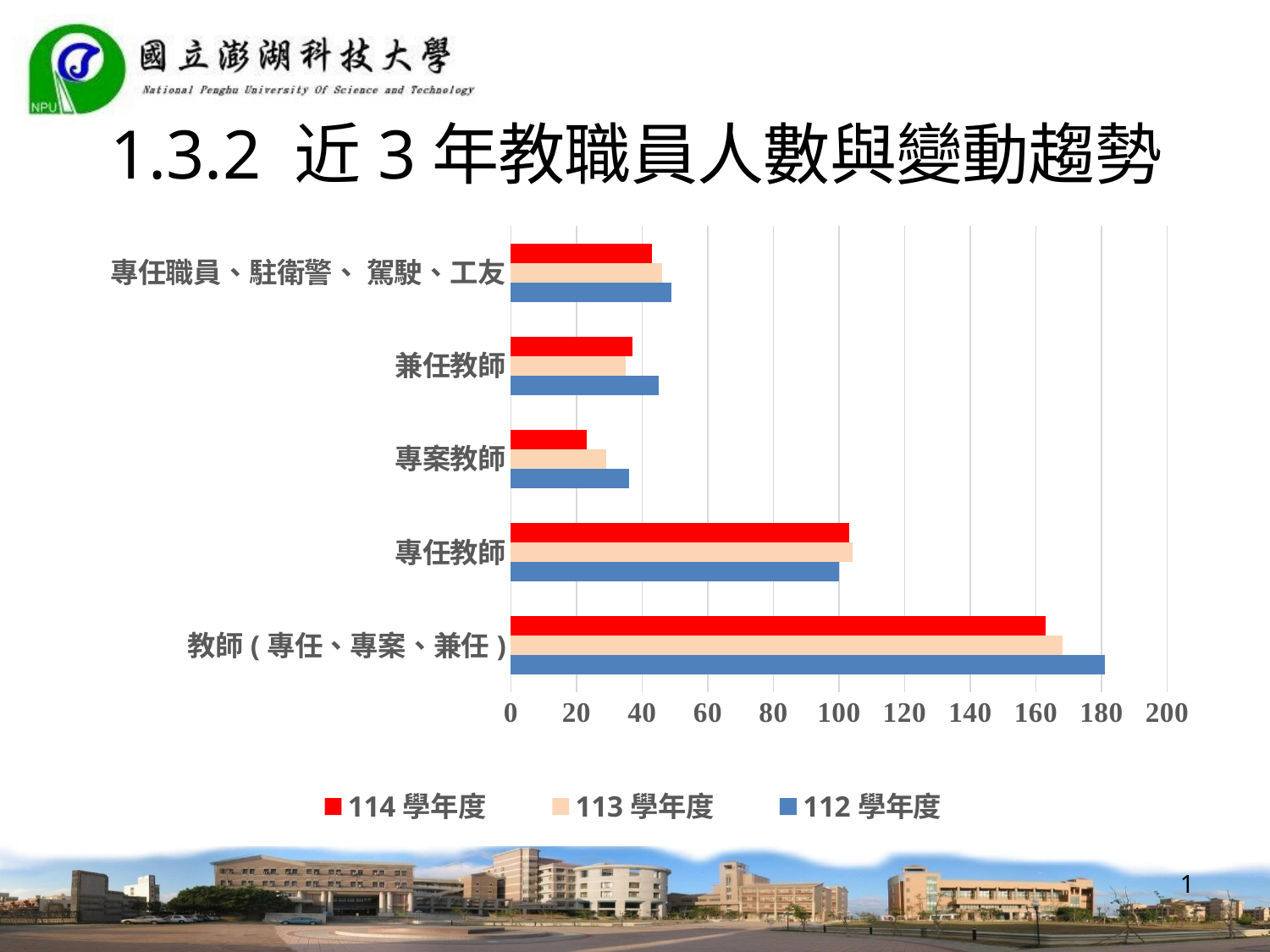
For 專案教師, which is larger: the value for 112 學年度 or 114 學年度? 112 學年度 For 教師(專任、專案、兼任), which is larger: the value for 112 學年度 or 114 學年度? 112 學年度 Is the value for 專案教師 in 114 學年度 greater or less than 40? less Which category has the highest value for 112 學年度? 教師(專任、專案、兼任) Is the value for 教師(專任、專案、兼任) in 112 學年度 greater or less than 160? greater Is the value for 專任職員、駐衛警、駕駛、工友 in 114 學年度 greater or less than 60? less What kind of chart is shown on the slide? bar chart Which colour represents 114 學年度 in the legend? red How many series does the legend list? 3 Which category has the lowest value for 114 學年度? 專案教師 How many categories are shown on the chart? 5